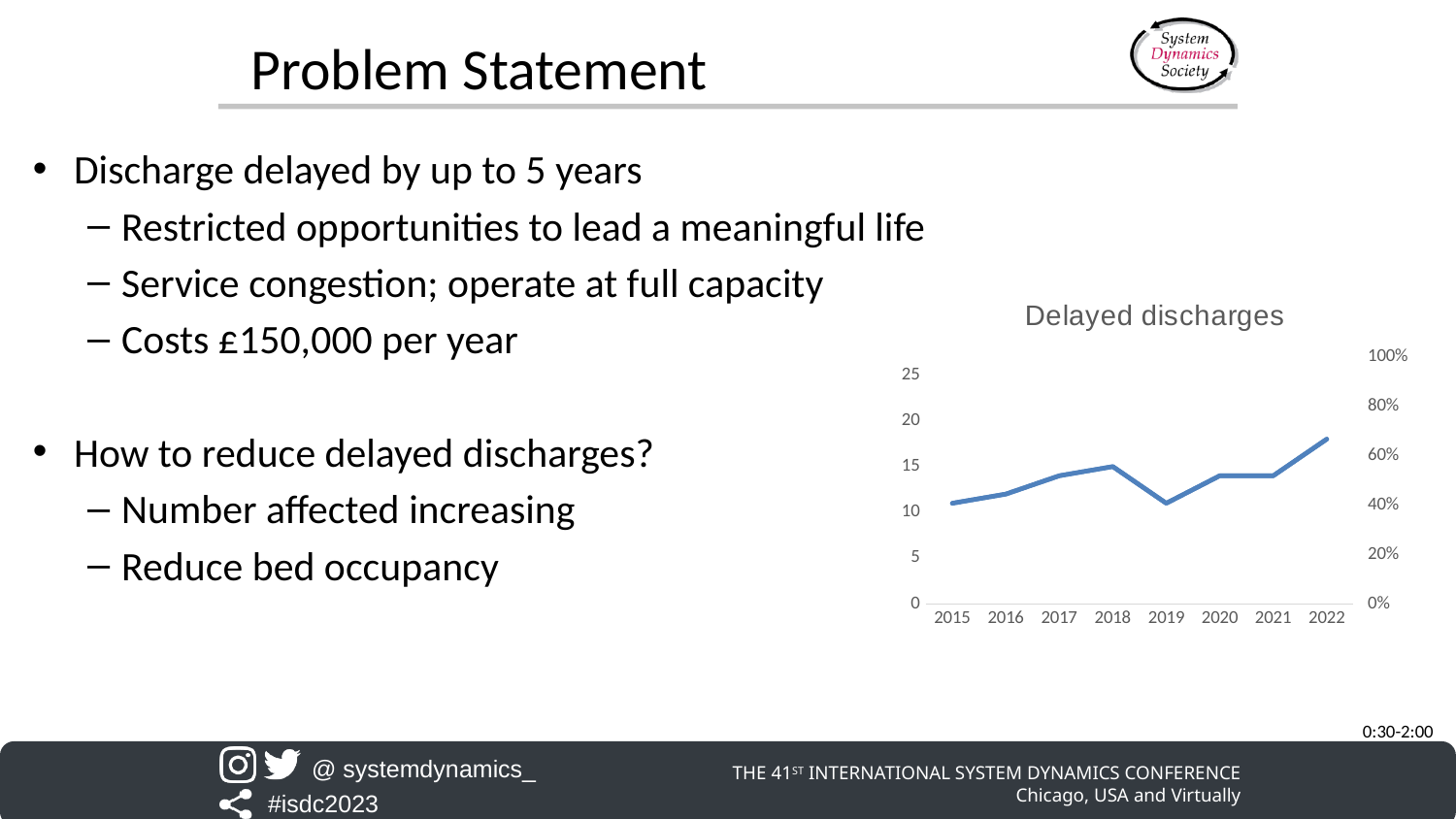
Is the value for 2018 greater or less than 20? less What is the title of the chart? Delayed discharges What is the highest tick value shown on the left vertical axis? 25 What type of chart is shown on the slide? line chart Is the value for 2015 greater or less than 15? less Which year has the larger value, 2019 or 2022? 2022 Is the value for 2019 greater or less than 15? less Which year has the highest value in the Delayed discharges chart? 2022 Which year has the larger value, 2016 or 2018? 2018 How many years are plotted along the x axis of the chart? 8 Overall, do the values rise or fall from 2015 to 2022? rise